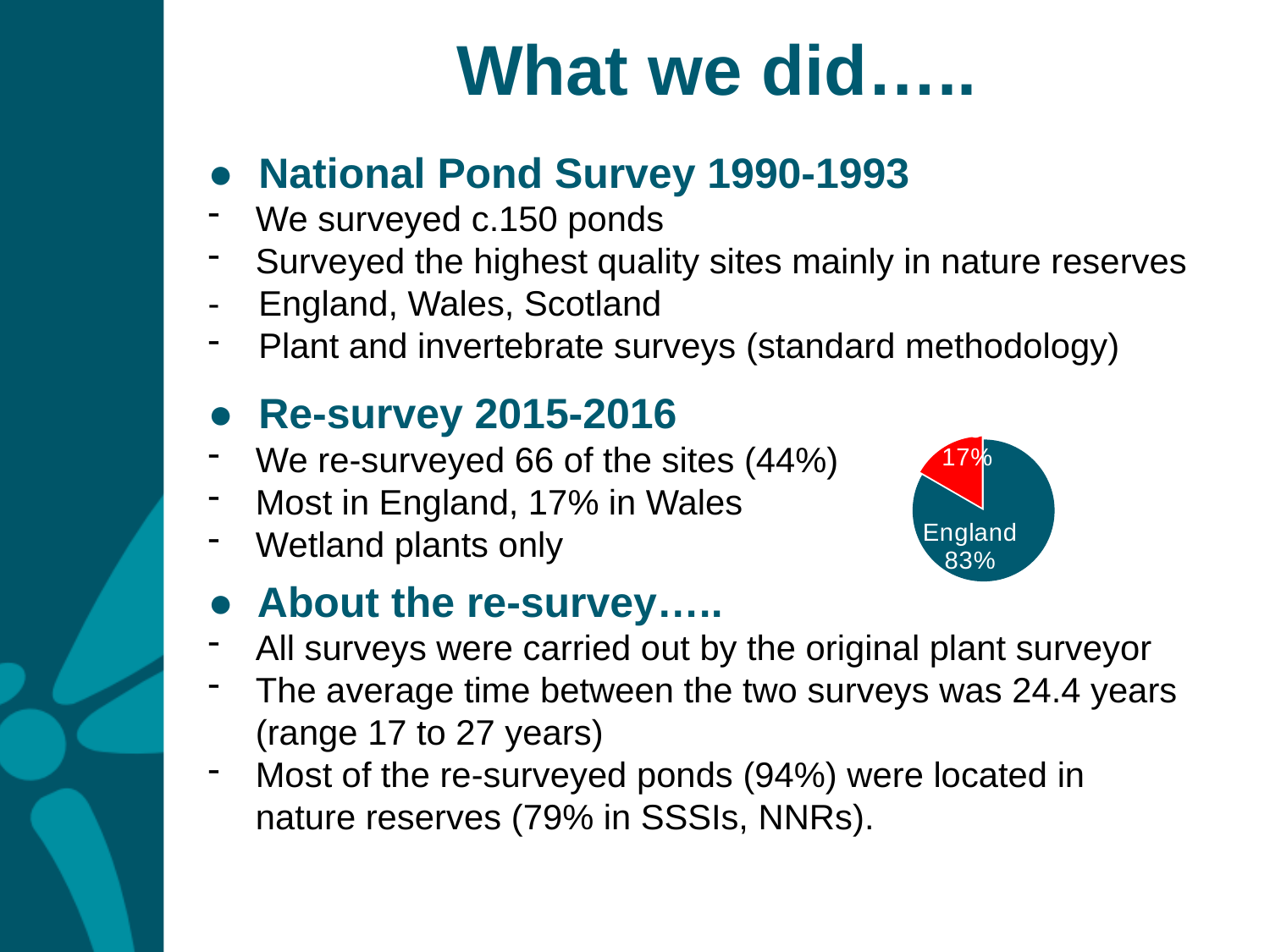
What do the two slices of the pie chart add up to? 100% How many slices does the pie chart have? 2 What kind of chart is shown on the slide? pie chart Which is larger in the pie chart, the England slice or the red slice? England What colour is the England slice of the pie chart? dark teal What is the difference in percentage points between the England slice and the 17% slice? 66 What colour is the 17% slice of the pie chart? red What percentage is shown on the red slice of the pie chart? 17% Is the England slice of the pie chart greater or less than 50%? greater What share of the pie chart is labelled England? 83% Which slice of the pie chart is the largest? England Which slice of the pie chart is the smallest? the red 17% slice